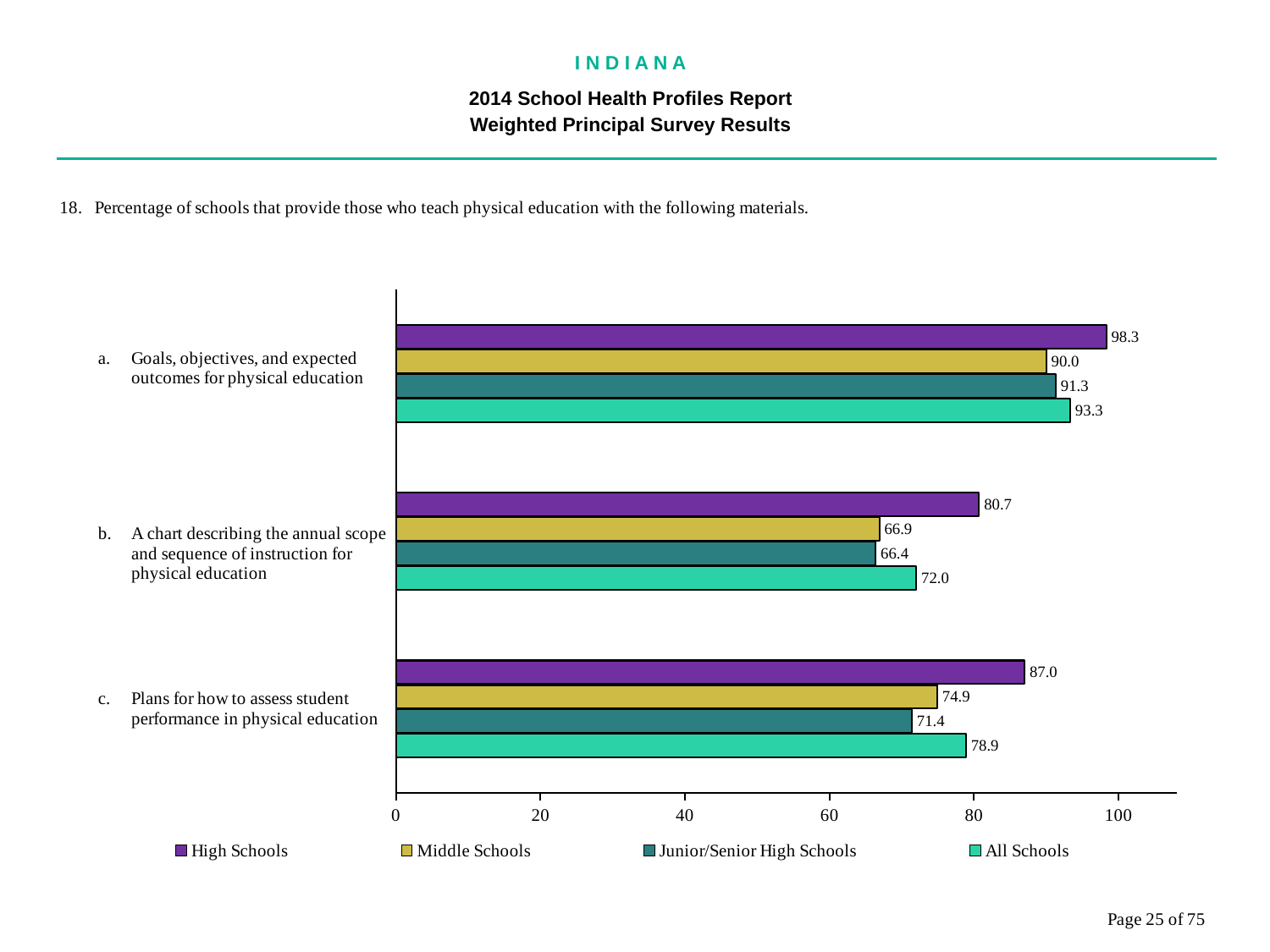
What is the difference between the High Schools and Middle Schools values for 'A chart describing the annual scope and sequence of instruction for physical education'? 13.8 Which school type has the lowest value for 'A chart describing the annual scope and sequence of instruction for physical education'? Junior/Senior High Schools Which is larger for 'Goals, objectives, and expected outcomes for physical education': the Middle Schools value or the All Schools value? All Schools What is the value for All Schools for 'A chart describing the annual scope and sequence of instruction for physical education'? 72.0 What is the value for Junior/Senior High Schools for 'Plans for how to assess student performance in physical education'? 71.4 Which school type has the highest value for 'Plans for how to assess student performance in physical education'? High Schools How many series does the legend list? 4 Is the Middle Schools value for 'Plans for how to assess student performance in physical education' greater or less than 80? less What kind of chart is shown on the slide? Bar chart What is the value for High Schools for 'Goals, objectives, and expected outcomes for physical education'? 98.3 How many material categories are shown on the chart? 3 Which legend entry is shown in purple? High Schools